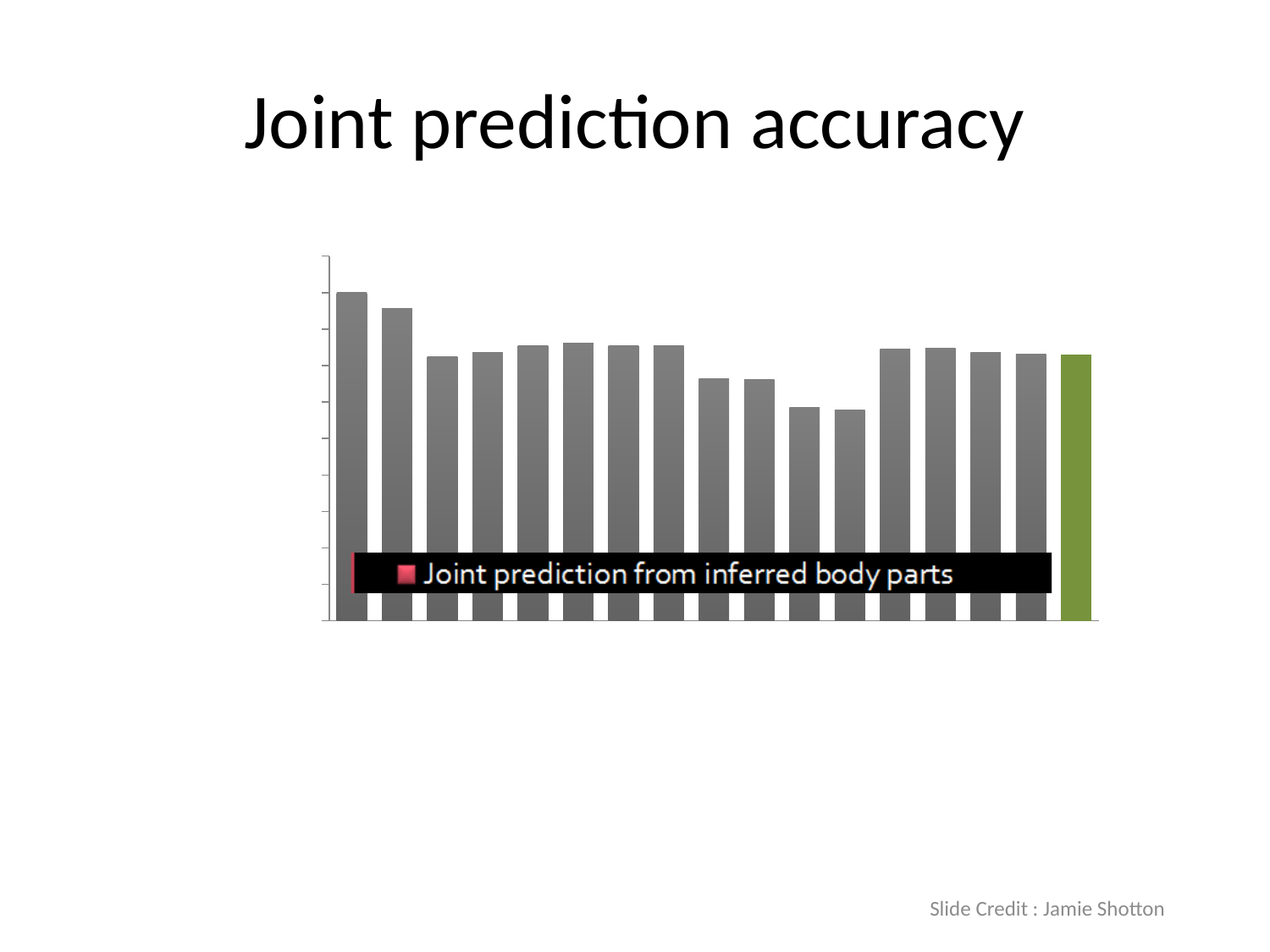
Which is taller, the second bar from the left or the third bar from the left? the second bar from the left How many series does the chart's legend list? 1 What is the title of the slide containing the chart? Joint prediction accuracy Which bar in the chart is the tallest? the first (leftmost) bar What is the legend entry shown in the chart? Joint prediction from inferred body parts Which is taller, the leftmost bar or the rightmost (green) bar? the leftmost bar What kind of chart is shown on the slide? bar chart How many bars are plotted in the chart? 17